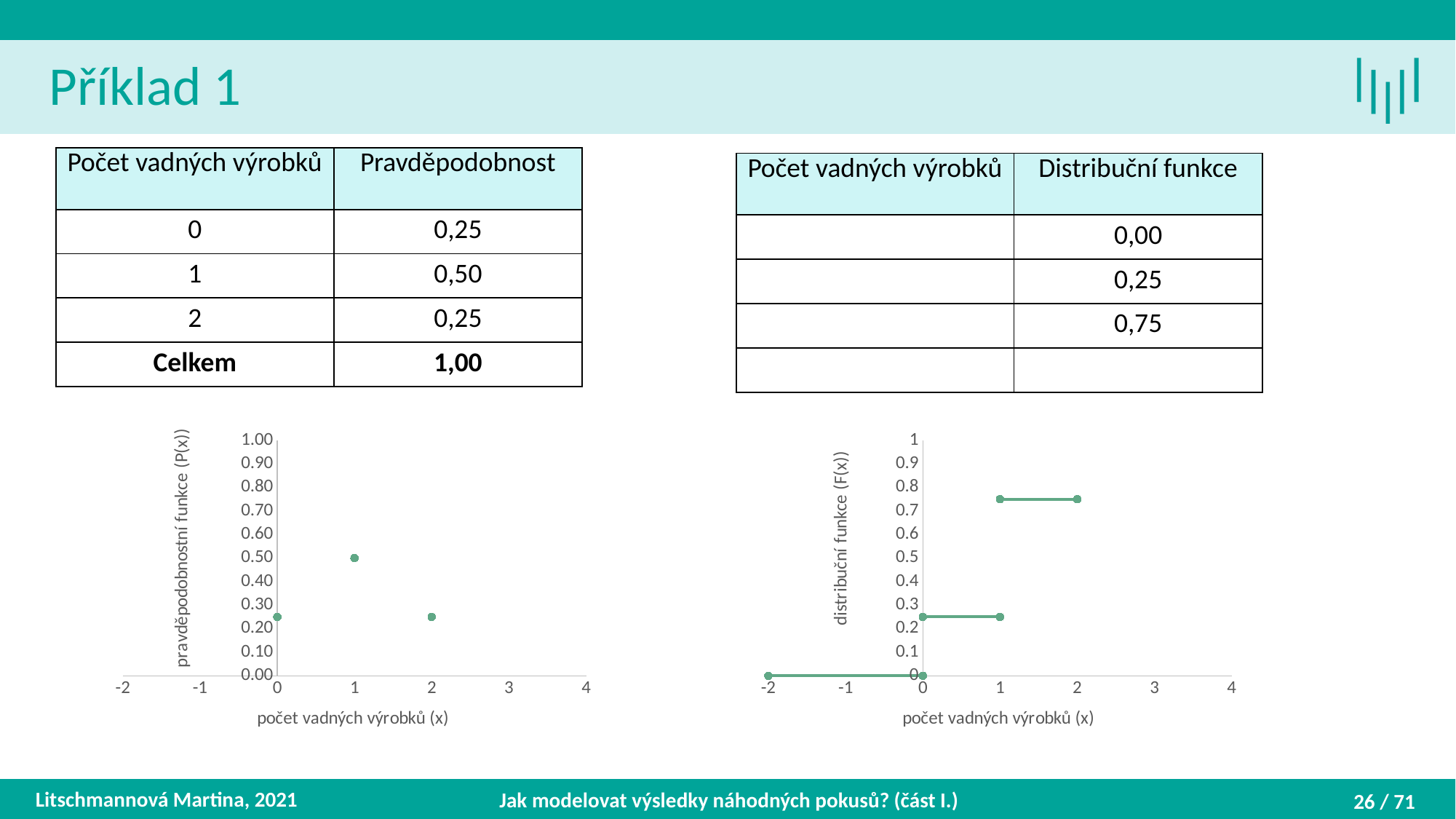
What is the y-axis label of the left chart? pravděpodobnostní funkce (P(x)) What kind of chart is the left chart (pravděpodobnostní funkce)? scatter chart How many data points are plotted in the left chart (pravděpodobnostní funkce)? 3 In the left chart (pravděpodobnostní funkce), which has the larger P(x): x = 1 or x = 2? x = 1 In the right chart (distribuční funkce), is the value of F(x) between x = 0 and x = 1 greater or less than 0.3? less In the right chart (distribuční funkce), do the values rise or fall as x increases? rise In the left chart (pravděpodobnostní funkce), what is the value of P(x) at x = 1? 0.50 In the left chart (pravděpodobnostní funkce), at which value of x is P(x) highest? 1 In the right chart (distribuční funkce), is the value of F(x) between x = 1 and x = 2 greater or less than 0.7? greater What is the x-axis label of the right chart (distribuční funkce)? počet vadných výrobků (x) In the left chart (pravděpodobnostní funkce), is the value at x = 0 greater or less than 0.30? less In the left chart (pravděpodobnostní funkce), what is the difference between P(x) at x = 1 and at x = 2? 0.25